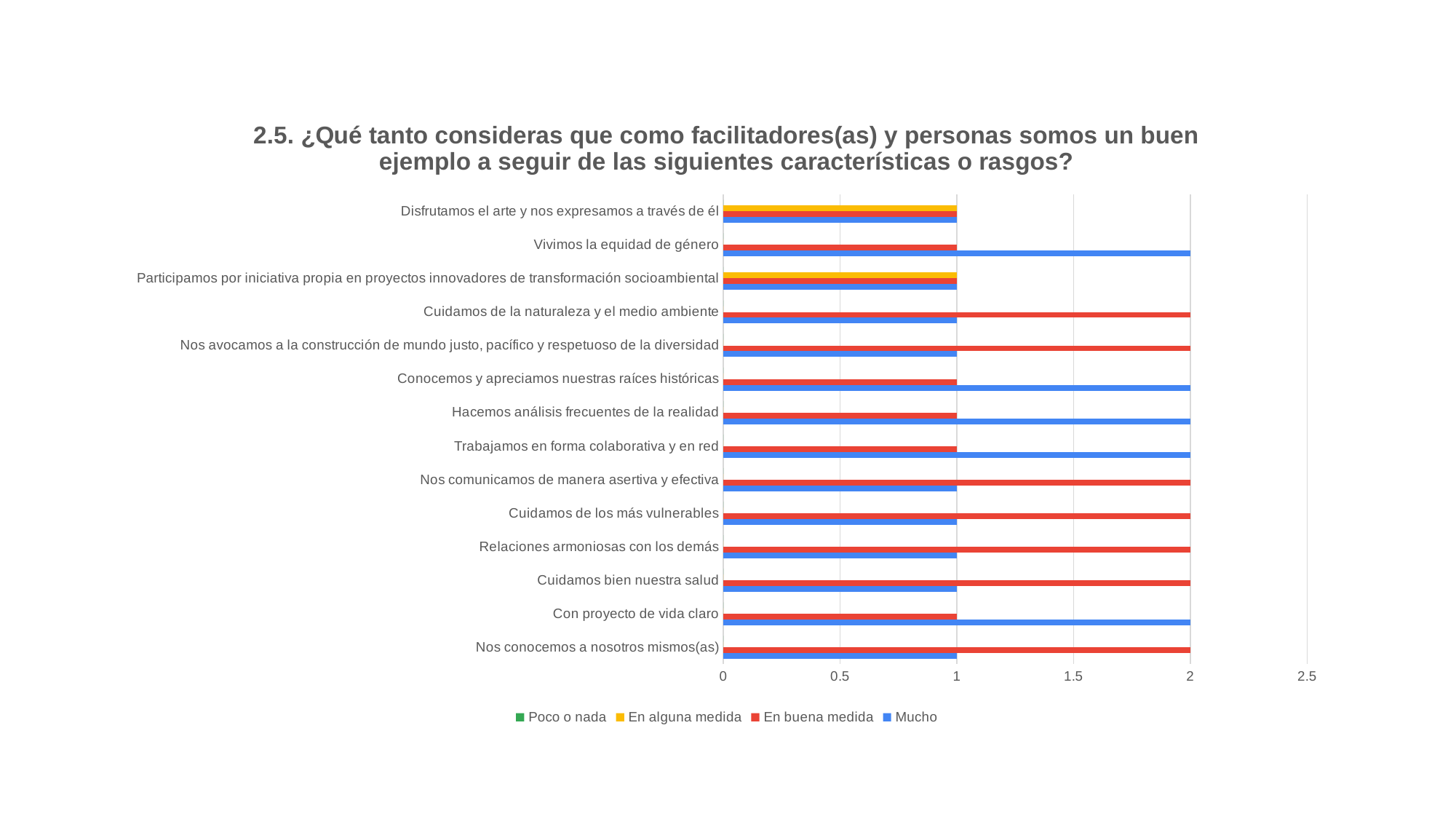
What kind of chart is shown on the slide? bar chart For "Con proyecto de vida claro", which is larger: "En buena medida" or "Mucho"? Mucho How many series does the legend list? 4 Which legend entry is shown in blue? Mucho What is the value of "En alguna medida" for "Disfrutamos el arte y nos expresamos a través de él"? 1 How many categories are plotted on the chart? 14 Is the value of "Mucho" for "Trabajamos en forma colaborativa y en red" greater or less than 1.5? greater What is the value of "Mucho" for "Nos conocemos a nosotros mismos(as)"? 1 What is the difference between "Mucho" and "En buena medida" for "Hacemos análisis frecuentes de la realidad"? 1 What is the value of "En buena medida" for "Cuidamos bien nuestra salud"? 2 What is the value of "Mucho" for "Vivimos la equidad de género"? 2 For "Cuidamos de los más vulnerables", which is larger: "En buena medida" or "Mucho"? En buena medida